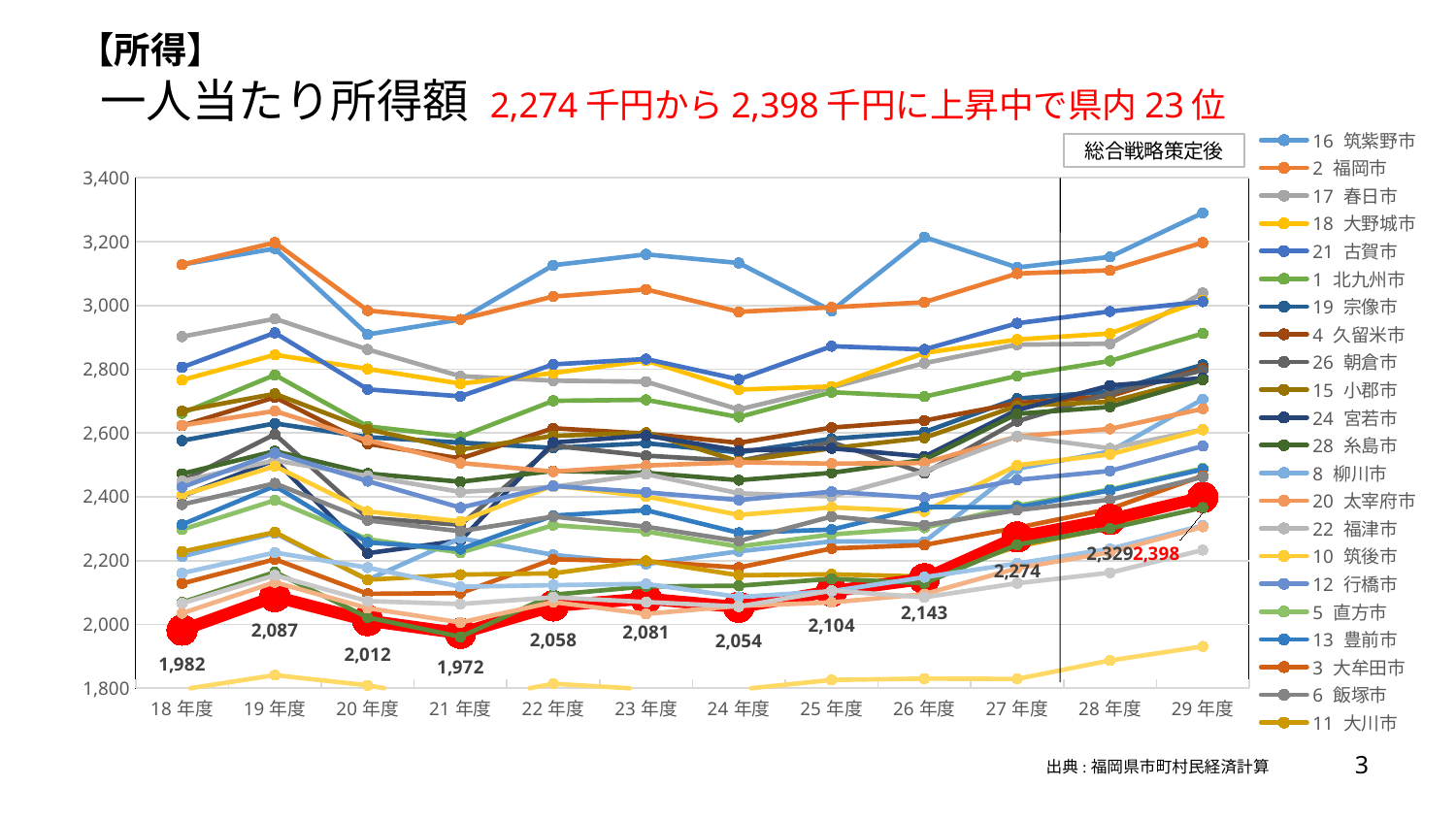
Does the red highlighted line rise or fall from 27年度 to 29年度? rise What kind of chart is shown on the slide? line chart Is the value for 16 筑紫野市 at 29年度 greater or less than 3,200? greater In which fiscal year does the red highlighted line reach its highest labelled value? 29年度 What is the value of the red highlighted line at 27年度? 2,274 In which fiscal year does the red highlighted line reach its lowest labelled value? 21年度 What is the difference between the red line's values at 29年度 and 27年度? 124 Which is larger on the red highlighted line: the value at 19年度 or at 20年度? 19年度 What is the value of the red highlighted line at 29年度? 2,398 What is the value of the red highlighted line at 18年度? 1,982 What is the label on the vertical marker line near 28年度? 総合戦略策定後 How many fiscal years are shown on the x axis? 12